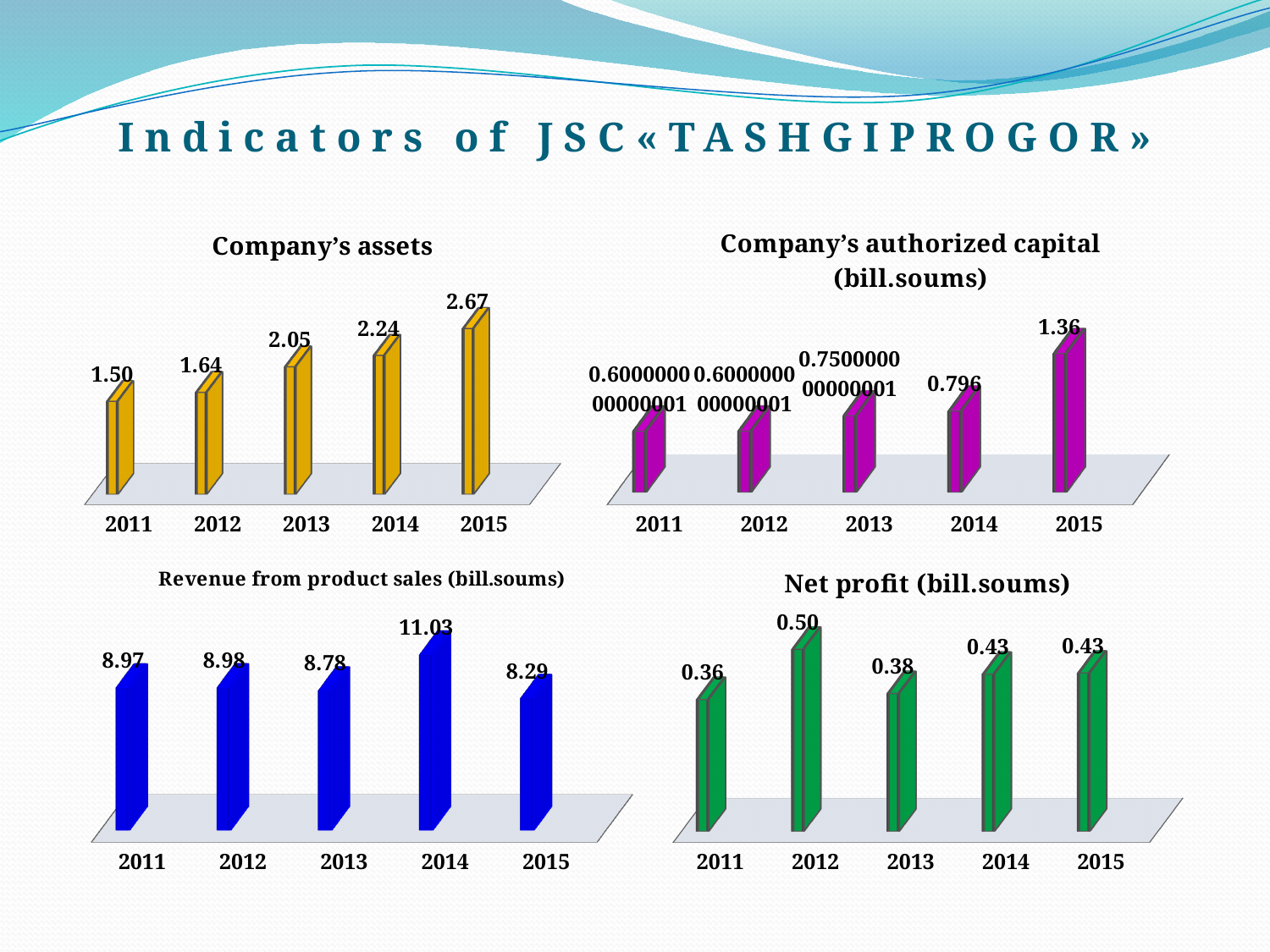
In the 'Company's assets' chart, what is the difference between the 2015 and 2011 values? 1.17 In the 'Company's assets' chart, do the values rise or fall from 2011 to 2015? rise In the 'Revenue from product sales (bill.soums)' chart, which year has the highest value? 2014 In the 'Net profit (bill.soums)' chart, which year has the highest value? 2012 How many charts are shown on the slide? 4 In the 'Company's authorized capital (bill.soums)' chart, which year has the highest value? 2015 In the 'Company's authorized capital (bill.soums)' chart, what is the value for 2014? 0.796 In the 'Revenue from product sales (bill.soums)' chart, what is the difference between the 2014 and 2015 values? 2.74 In the 'Company's authorized capital (bill.soums)' chart, what is the value for 2015? 1.36 In the 'Revenue from product sales (bill.soums)' chart, which year has the lowest value? 2015 In the 'Company's assets' chart, what is the value for 2015? 2.67 In the 'Company's assets' chart, what is the value for 2011? 1.50